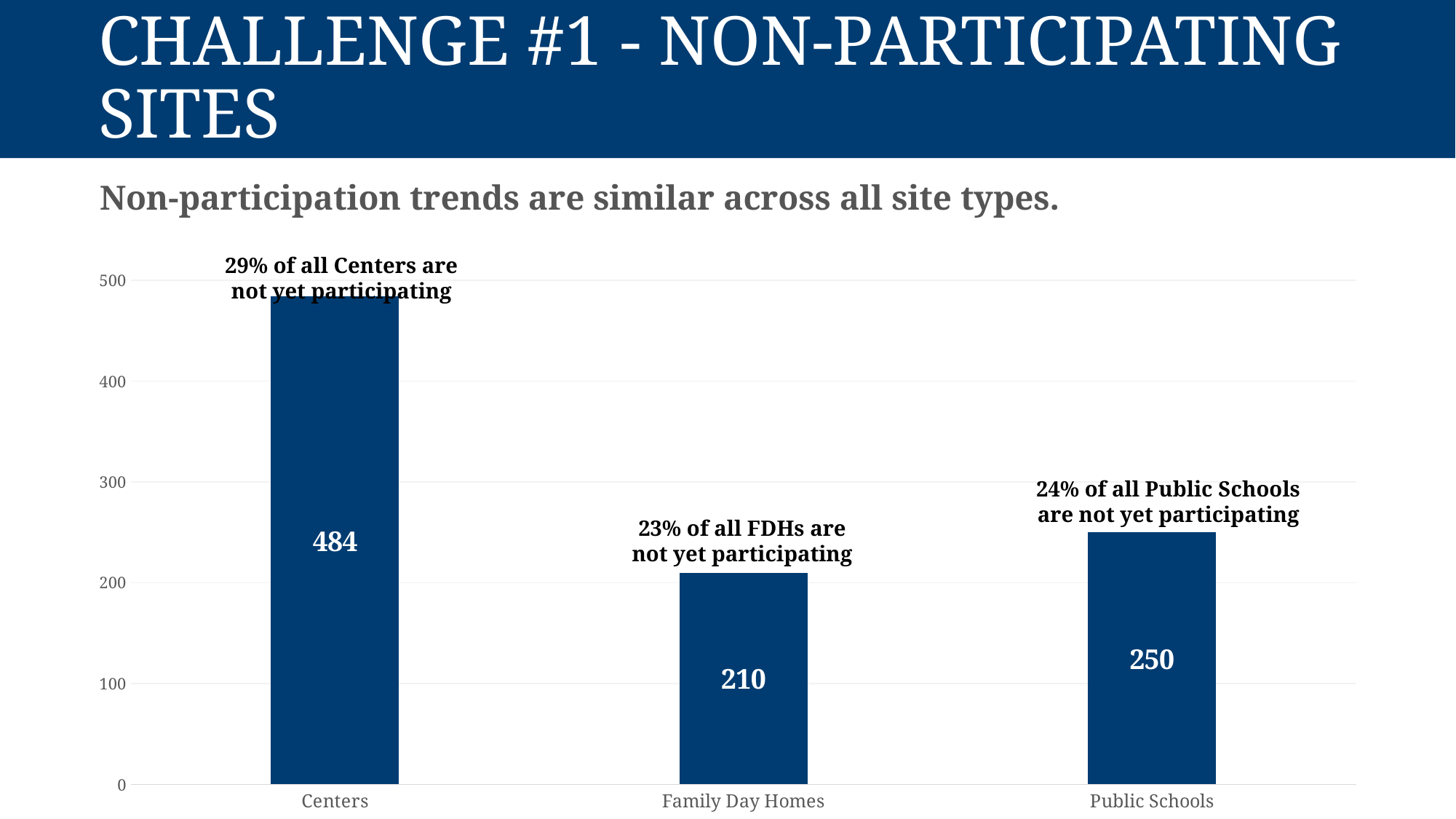
What is the difference between the values for Public Schools and Family Day Homes? 40 How many categories are shown on the chart? 3 What is the value for Family Day Homes? 210 Which category has the highest value? Centers What is the difference between the values for Centers and Public Schools? 234 What kind of chart is shown on the slide? bar chart Which category has the lowest value? Family Day Homes According to the annotation on the chart, what percentage of all Public Schools are not yet participating? 24% What is the value for Centers? 484 Is the value for Centers greater or less than 400? greater What is the value for Public Schools? 250 Which is larger, the value for Family Day Homes or the value for Public Schools? Public Schools